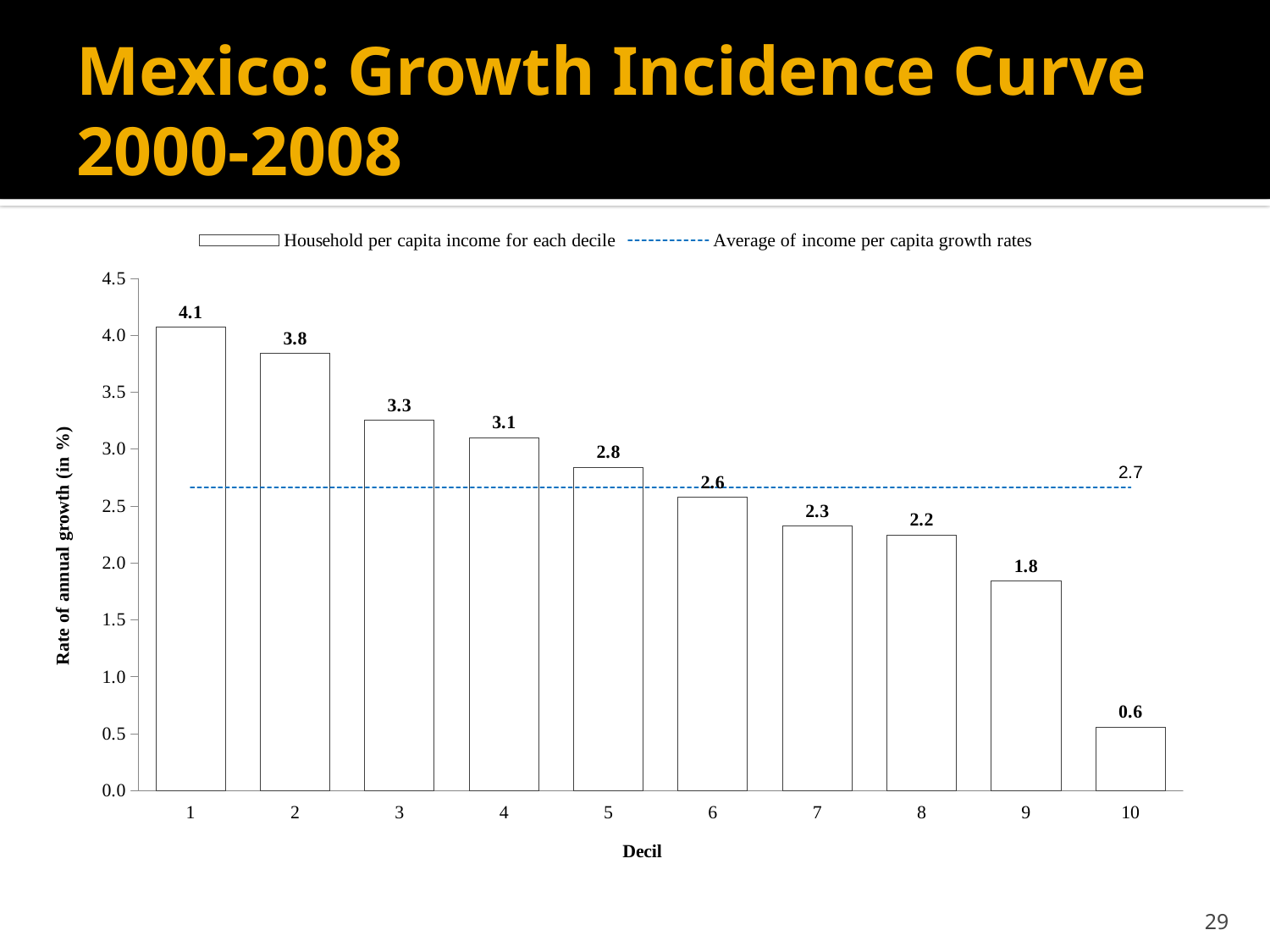
Which decile has the highest rate of annual growth? 1 What is the rate of annual growth for decile 1? 4.1 Do the growth rates rise or fall as the decile number increases? Fall What kind of chart is used to show household per capita income growth for each decile? Bar chart How many series does the legend list? 2 Which has a higher rate of annual growth, decile 3 or decile 7? Decile 3 What is the difference between the growth rates of decile 1 and decile 10? 3.5 What is the rate of annual growth for decile 10? 0.6 Which decile has the lowest rate of annual growth? 10 How many deciles are shown on the x axis? 10 What value is labelled on the dashed line for the average of income per capita growth rates? 2.7 What is the rate of annual growth for decile 5? 2.8